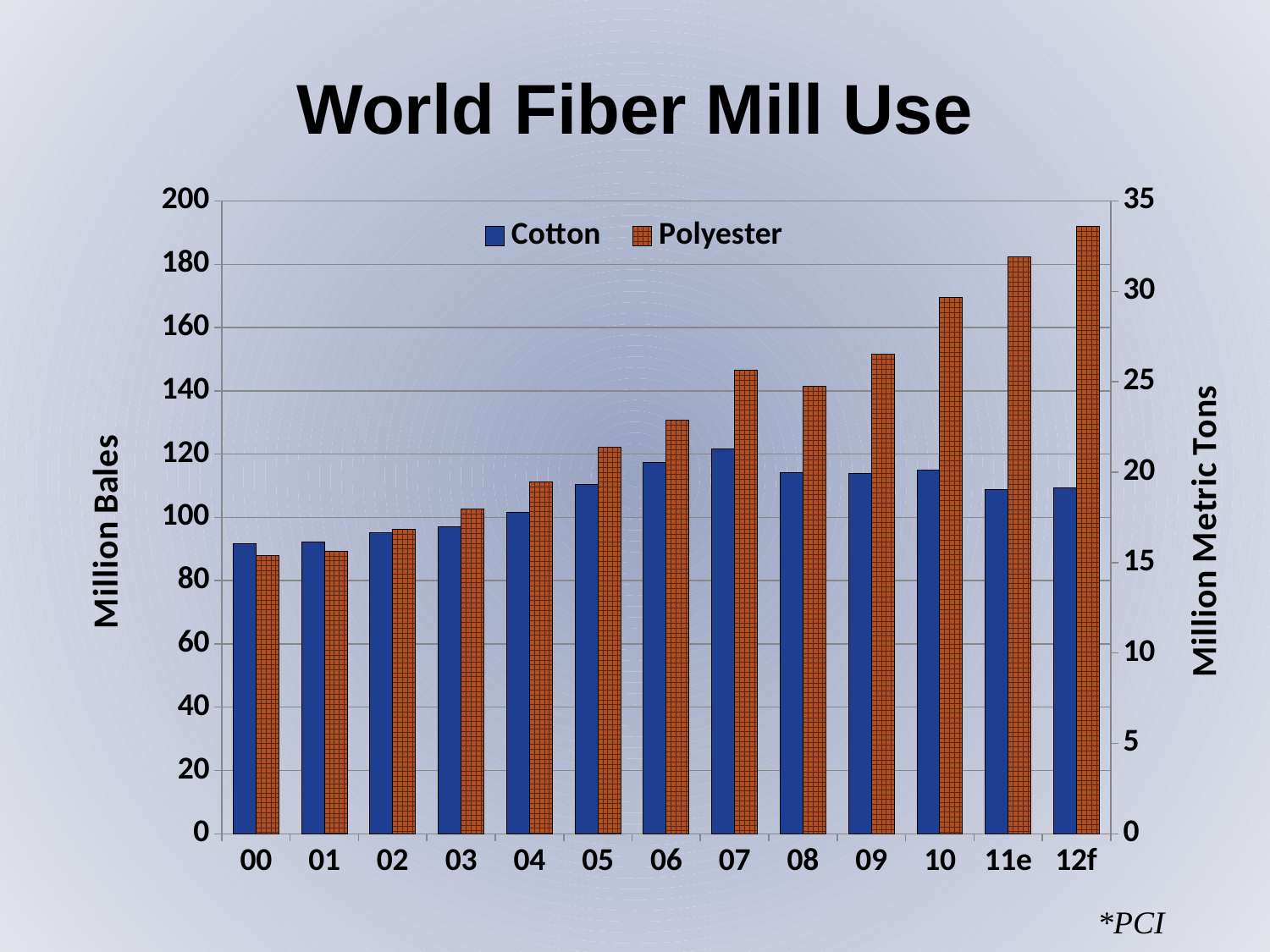
Is the Polyester value for 12f greater or less than 30 million metric tons? greater How many year categories are shown on the x axis? 13 Do the Polyester values generally rise or fall from 00 to 12f? rise What is the title of the right vertical axis? Million Metric Tons In which year is the Polyester bar highest? 12f Is the Cotton value for 00 greater or less than 100 million bales? less Which is larger, the Cotton value for 07 or the Cotton value for 00? 07 In which year is the Cotton bar highest? 07 What is the title of the left vertical axis? Million Bales Is the Cotton value for 10 greater or less than 100 million bales? greater What kind of chart is shown on the slide? bar chart How many series does the legend list? 2